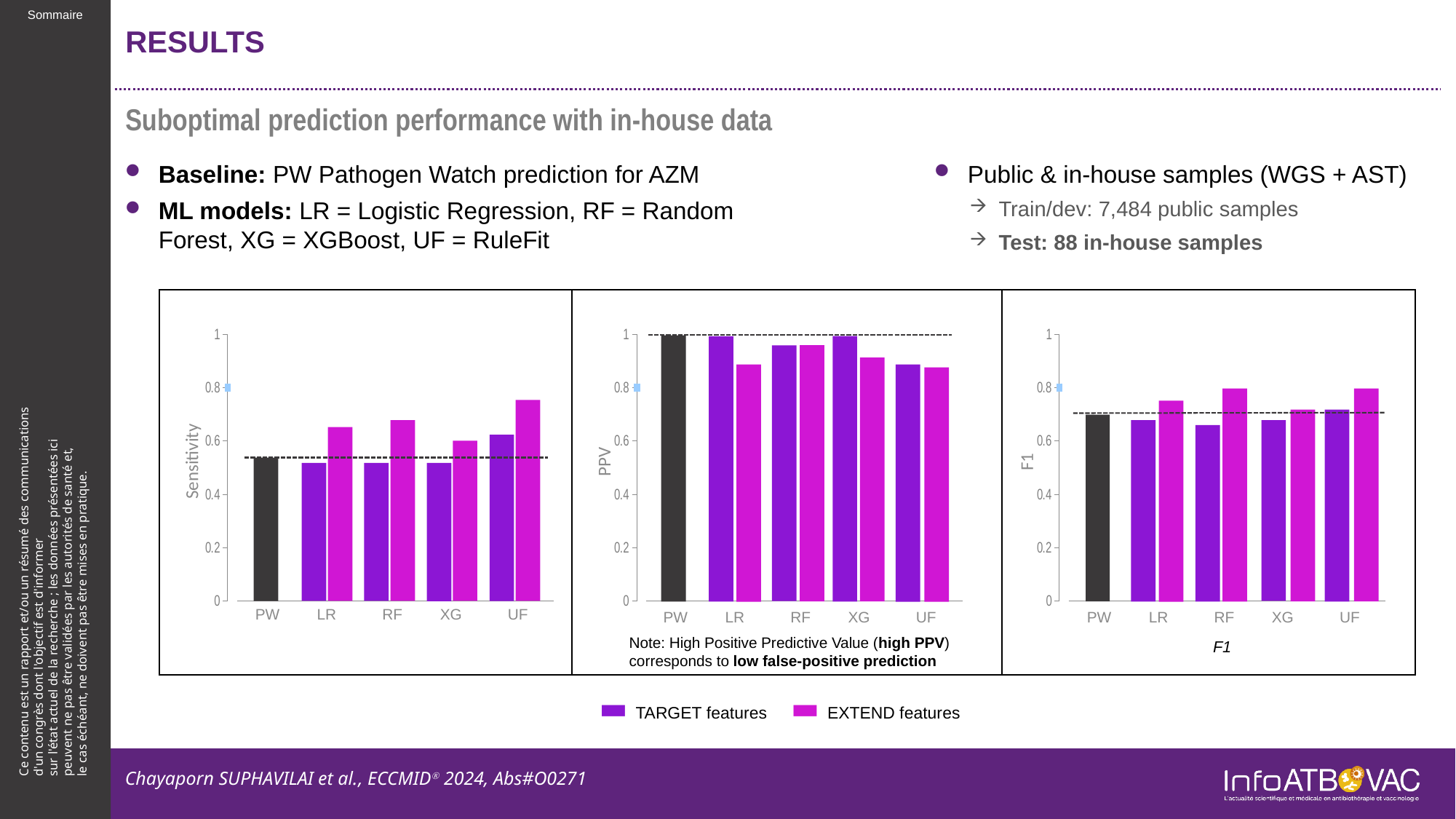
In the Sensitivity chart, which bar is the highest? UF, EXTEND features How many series does the legend below the charts list? 2 What kind of chart is the Sensitivity chart on the left? bar chart How many categories are shown on the x axis of the PPV chart? 5 In the Sensitivity chart, is the EXTEND features value for UF greater or less than 0.6? greater What is the y-axis label of the middle chart? PPV In the PPV chart, which is larger for XG: the TARGET features bar or the EXTEND features bar? TARGET features In the F1 chart, which is larger for RF: the TARGET features bar or the EXTEND features bar? EXTEND features In the F1 chart, is the EXTEND features value for RF greater or less than 0.6? greater In the Sensitivity chart, is the value for PW greater or less than 0.6? less In the Sensitivity chart, which is larger for RF: the TARGET features bar or the EXTEND features bar? EXTEND features